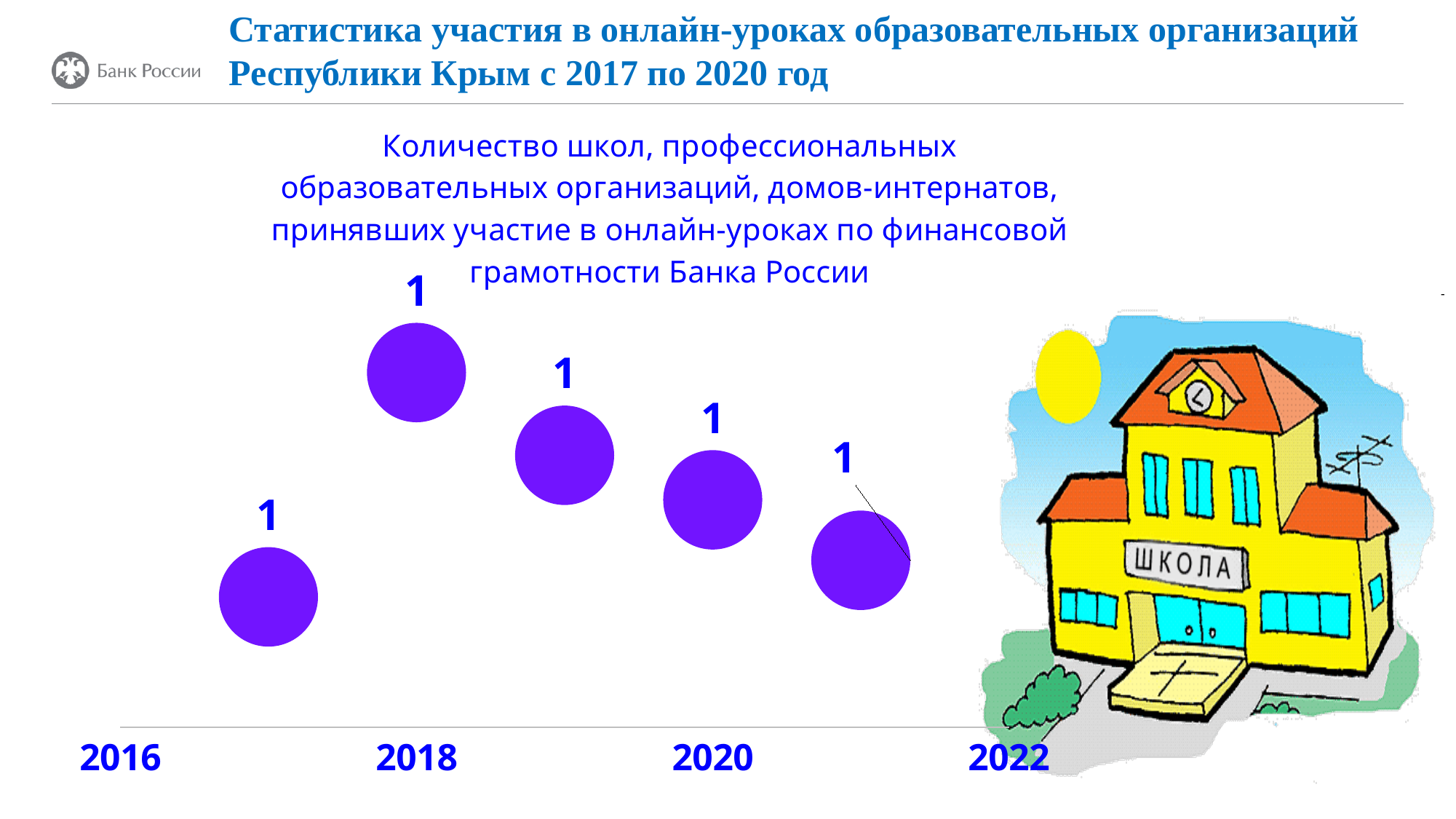
What is the first year label shown on the x axis? 2016 What colour are the bubbles on the chart? purple What is the data label shown above the bubble plotted at 2018? 1 What data label is printed above each bubble on the chart? 1 Which bubble is positioned highest on the chart: the one at 2018 or the one at 2020? 2018 Which bubble is positioned lowest on the chart, the first one (left) or the last one (right)? the first one (left) Do the bubbles rise or fall along the x axis from 2018 to 2021? fall How many data points (bubbles) are plotted on the chart? 5 What is the last year label shown on the x axis? 2022 What kind of chart is shown on the slide? bubble chart Which year's bubble sits highest on the chart? 2018